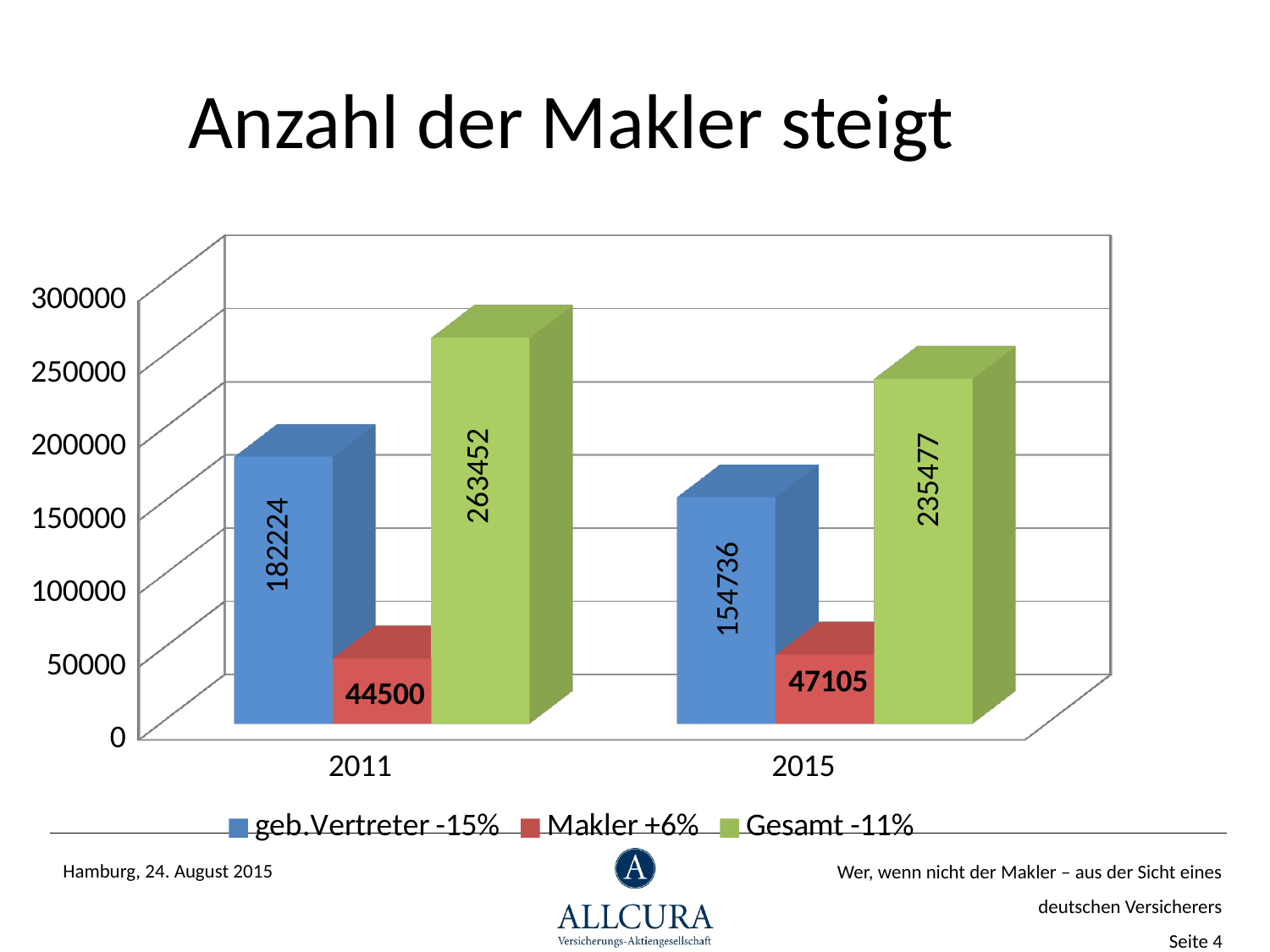
What is the difference between the Gesamt values for 2011 and 2015? 27975 What is the title of the slide? Anzahl der Makler steigt How many series does the legend list? 3 What kind of chart is shown on the slide? Bar chart Which series has the lowest value in 2015? Makler +6% What is the difference between the Makler values for 2015 and 2011? 2605 What is the value for Makler in 2015? 47105 Which series has the highest value in 2011? Gesamt -11% What is the value for Gesamt in 2015? 235477 What is the value for Makler in 2011? 44500 What is the value for geb.Vertreter in 2011? 182224 Is the value for geb.Vertreter larger in 2011 or in 2015? 2011